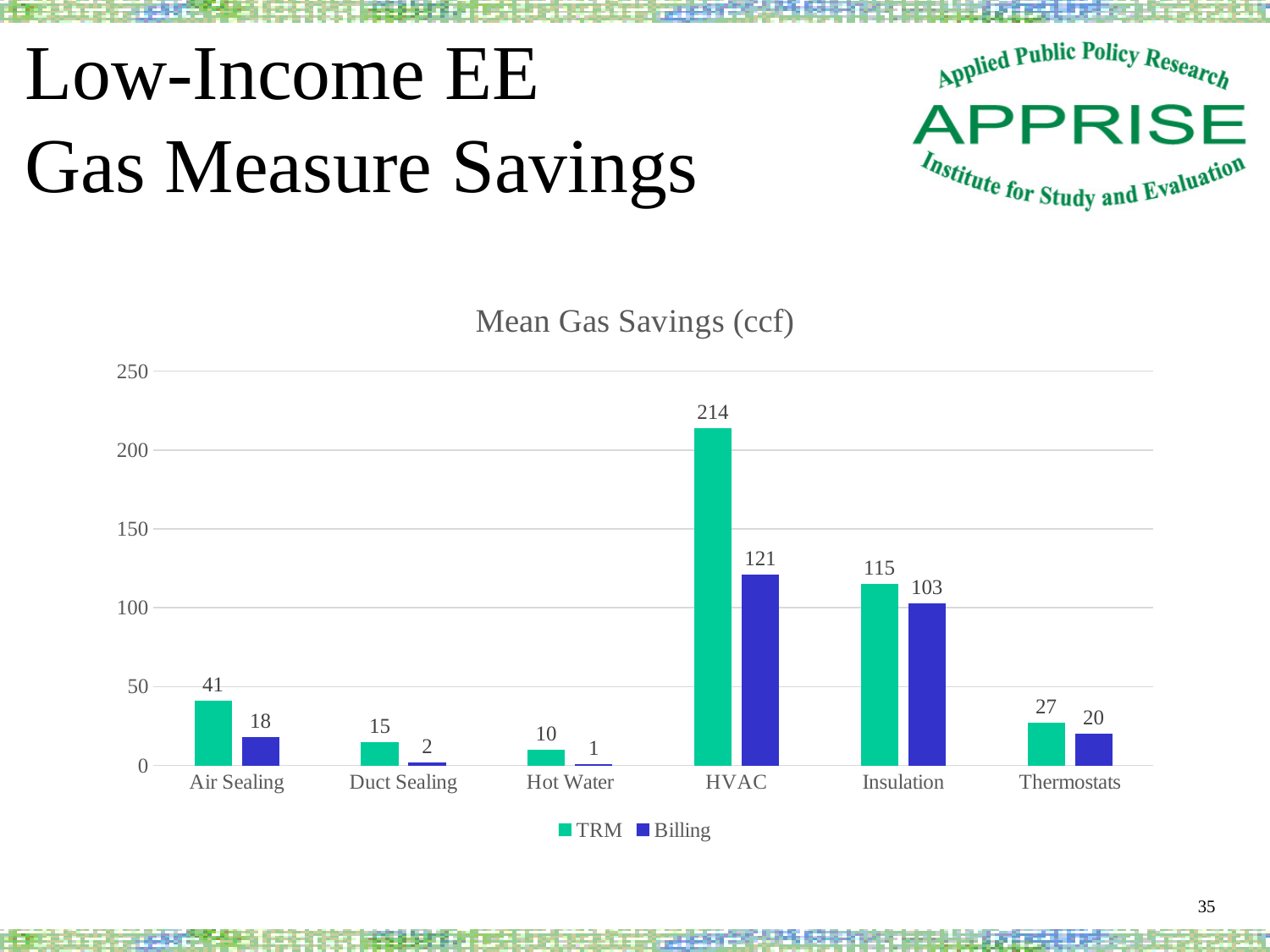
Which category has the highest TRM value? HVAC Which is larger, the TRM value for Air Sealing or the TRM value for Thermostats? Air Sealing Which category has the lowest Billing value? Hot Water What kind of chart is shown? bar chart How many series does the legend list? 2 How many categories are shown on the x axis? 6 What is the title of the chart? Mean Gas Savings (ccf) What is the Billing value for Duct Sealing? 2 What is the difference between the TRM and Billing values for HVAC? 93 What is the Billing value for Insulation? 103 Is the Billing value for HVAC greater or less than 100? greater What is the TRM value for HVAC? 214